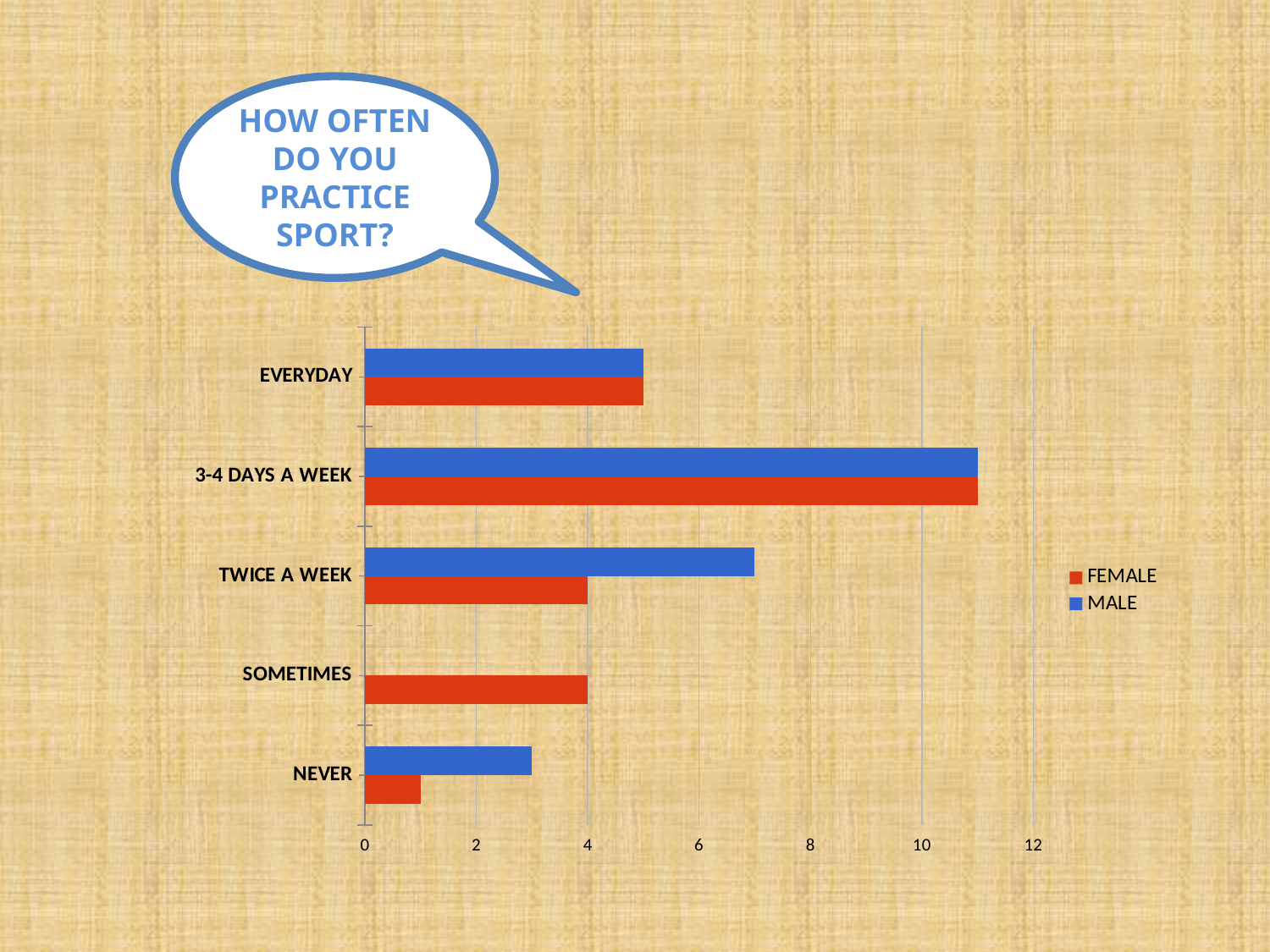
What is the FEMALE value for TWICE A WEEK? 4 Is the MALE value for 3-4 DAYS A WEEK greater or less than 10? greater What is the FEMALE value for SOMETIMES? 4 What kind of chart is shown on the slide? bar chart For TWICE A WEEK, which is larger, the MALE value or the FEMALE value? MALE Is the FEMALE value for NEVER greater or less than 2? less For NEVER, which is larger, the MALE value or the FEMALE value? MALE Which category has the lowest FEMALE value? NEVER Which category has the highest MALE value? 3-4 DAYS A WEEK How many categories are shown on the chart? 5 Which colour represents the FEMALE series in the legend? red How many series does the legend list? 2